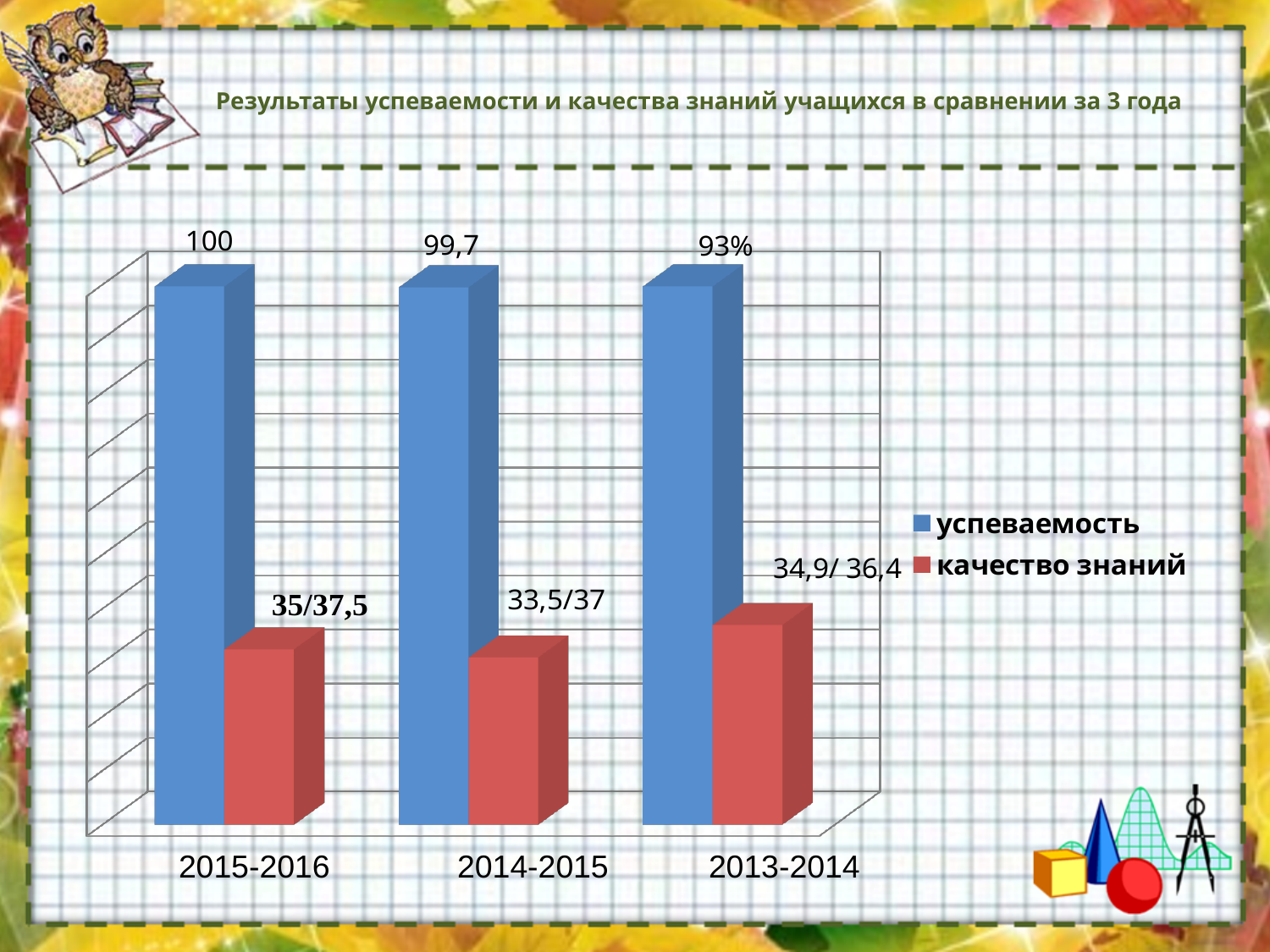
What label is shown for качество знаний in 2015-2016? 35/37,5 What is the value of успеваемость for 2014-2015? 99,7 Which is larger in 2014-2015: успеваемость or качество знаний? успеваемость What label is shown for качество знаний in 2014-2015? 33,5/37 How many year categories are shown on the x axis? 3 Which year has the highest успеваемость value? 2015-2016 Which year has the lowest успеваемость value? 2013-2014 How many series does the legend list? 2 What is the value of успеваемость for 2015-2016? 100 What is the value of успеваемость for 2013-2014? 93% What label is shown for качество знаний in 2013-2014? 34,9/ 36,4 What kind of chart is shown on the slide? bar chart